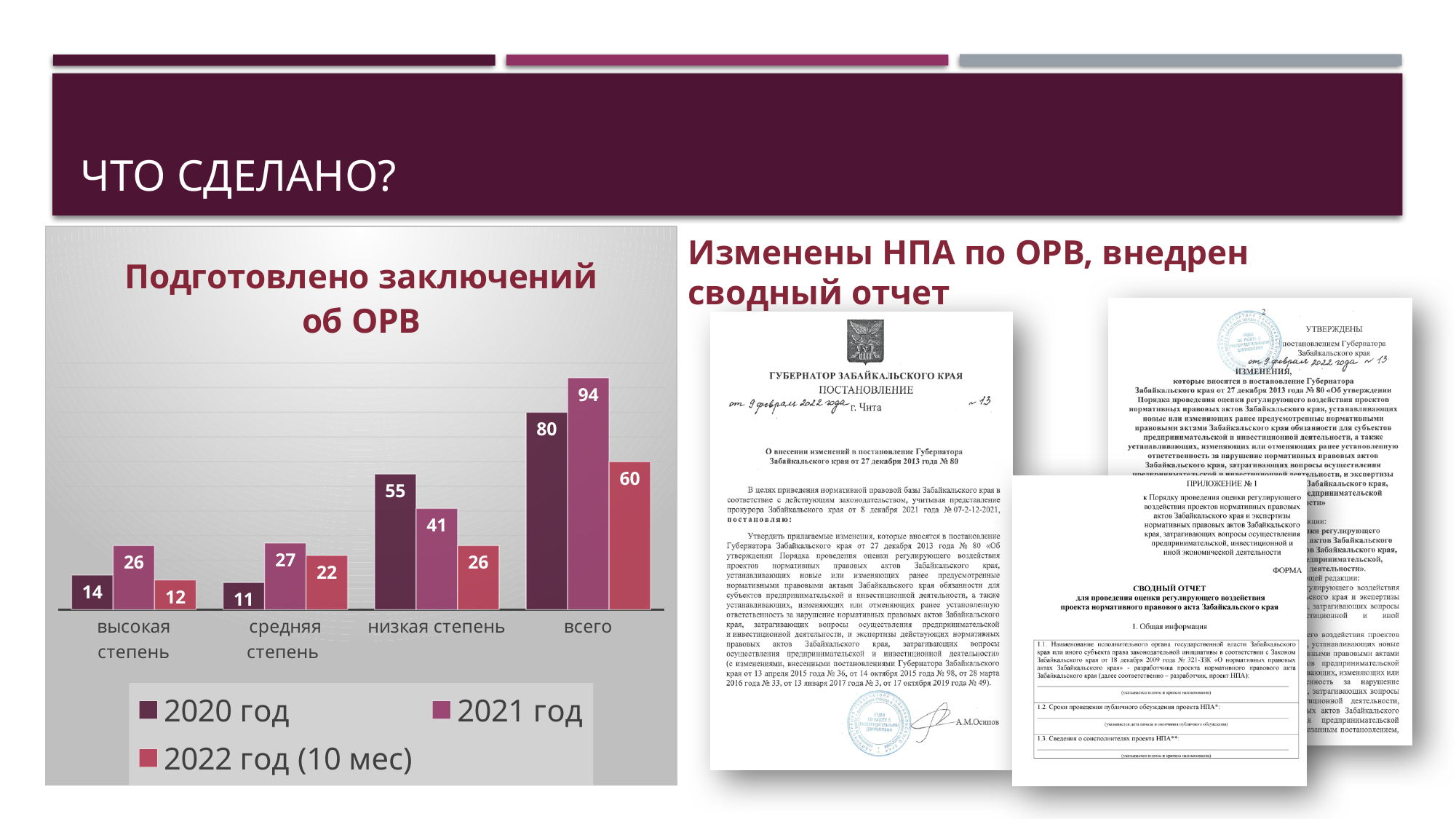
What is the value for 2021 год in the category низкая степень? 41 How many categories are shown on the x axis of the chart? 4 Which series has the highest value in the category всего? 2021 год What is the title of the chart? Подготовлено заключений об ОРВ Which series has the lowest value in the category высокая степень? 2022 год (10 мес) What is the value for 2020 год in the category всего? 80 What type of chart is shown on the slide? bar chart Which is larger in the category низкая степень: the value for 2020 год or for 2021 год? 2020 год How many series does the chart legend list? 3 What is the value for 2022 год (10 мес) in the category средняя степень? 22 What is the difference between the 2021 год and 2020 год values in the category всего? 14